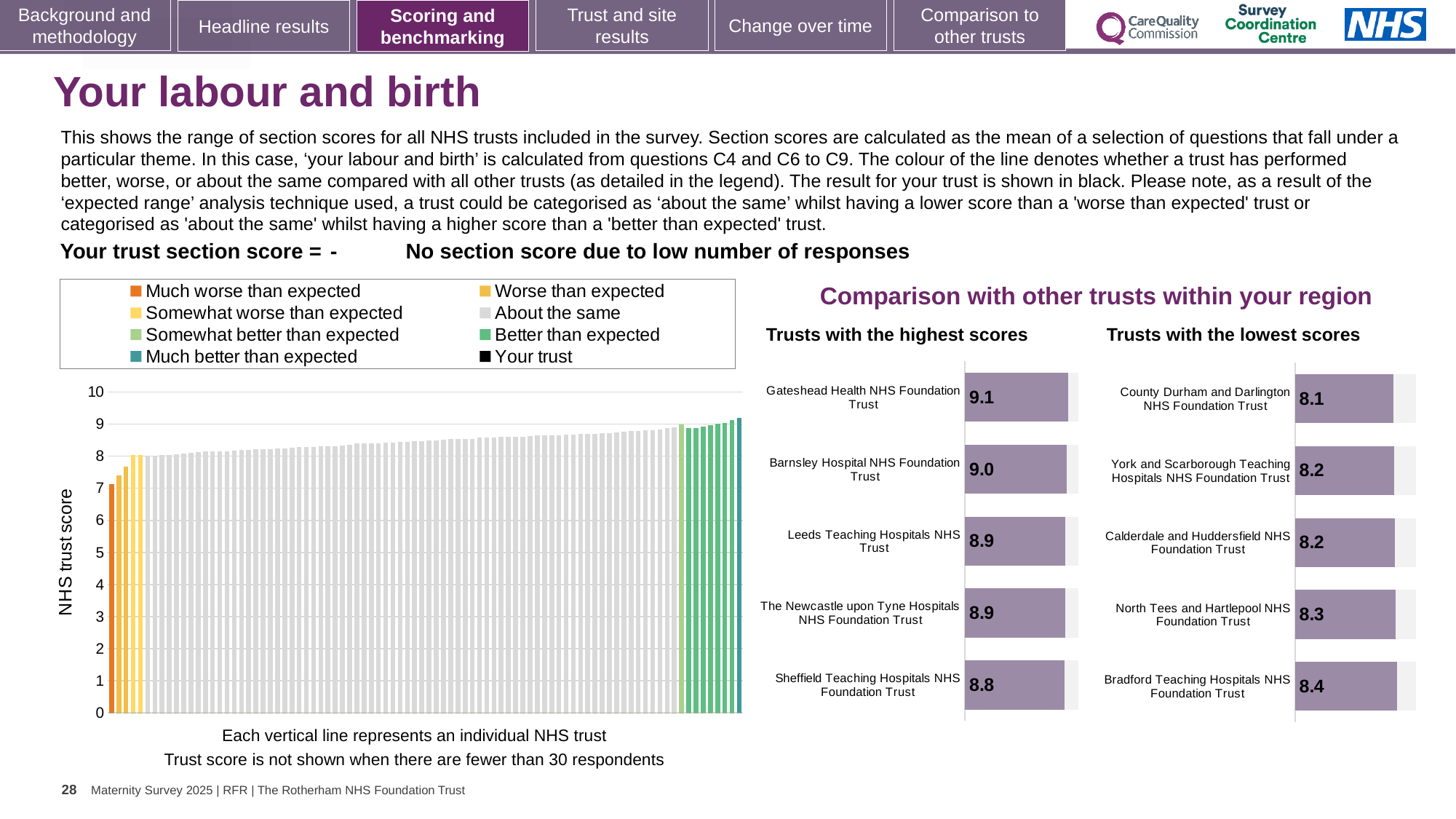
In the main 'NHS trust score' chart, do the values rise or fall from left to right? Rise In the 'Trusts with the lowest scores' chart, which trust has the highest score shown? Bradford Teaching Hospitals NHS Foundation Trust In the 'Trusts with the highest scores' chart, which trust has the lowest score shown? Sheffield Teaching Hospitals NHS Foundation Trust In the 'Trusts with the highest scores' chart, what is the score for Gateshead Health NHS Foundation Trust? 9.1 How many trusts are listed in the 'Trusts with the lowest scores' chart? 5 In the 'Trusts with the lowest scores' chart, which trust has the lowest score? County Durham and Darlington NHS Foundation Trust In the 'Trusts with the highest scores' chart, what is the difference between the scores of Gateshead Health NHS Foundation Trust and Sheffield Teaching Hospitals NHS Foundation Trust? 0.3 In the 'Trusts with the lowest scores' chart, what is the score for North Tees and Hartlepool NHS Foundation Trust? 8.3 In the 'Trusts with the highest scores' chart, which has the higher score: Barnsley Hospital NHS Foundation Trust or Leeds Teaching Hospitals NHS Trust? Barnsley Hospital NHS Foundation Trust How many entries does the legend of the main 'NHS trust score' chart list? 8 In the main 'NHS trust score' chart, is the value of the rightmost bar greater or less than 8? greater What kind of chart is the main 'NHS trust score' chart on the left? Bar chart